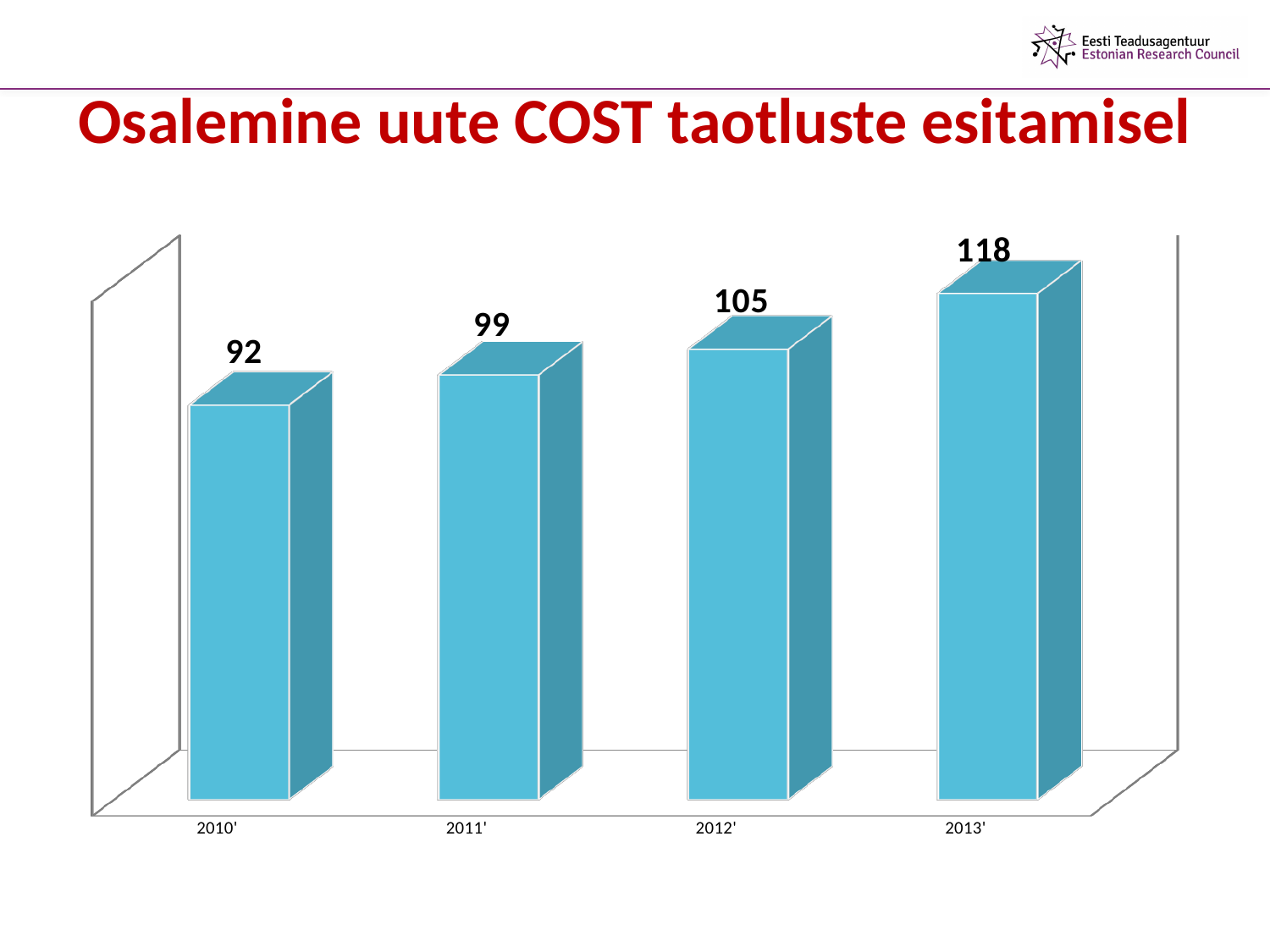
What is the value for 2011'? 99 What is the value for 2012'? 105 What is the difference between the values for 2012' and 2011'? 6 What is the difference between the values for 2013' and 2010'? 26 Which year has the lowest value? 2010' How many years are shown on the chart? 4 What kind of chart is shown on the slide? bar chart Which is larger, the value for 2011' or the value for 2012'? 2012' Do the values rise or fall from 2010' to 2013'? rise What is the value for 2013'? 118 What is the value for 2010'? 92 Which year has the highest value? 2013'